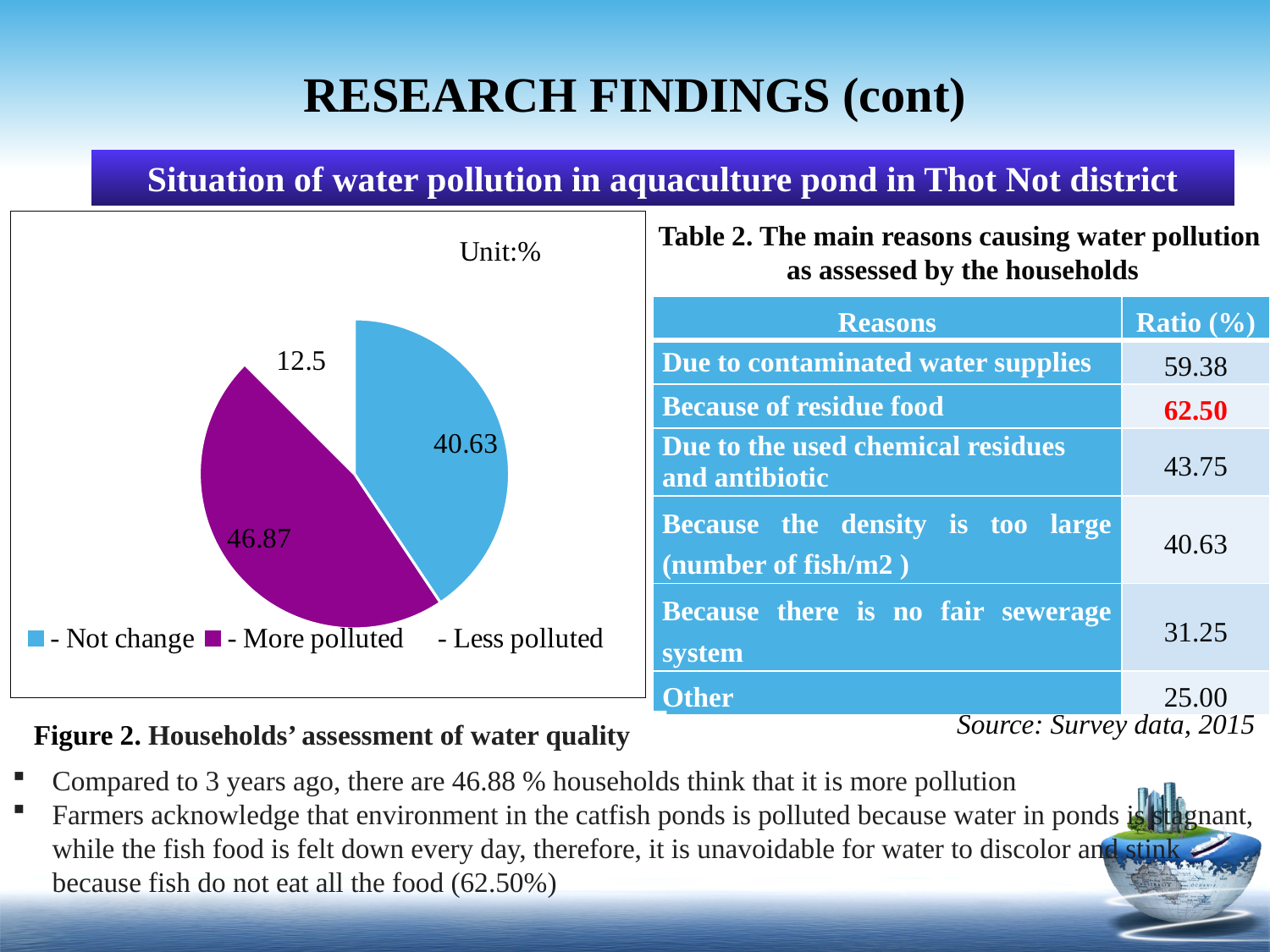
In the pie chart, what is the value for 'More polluted'? 46.87 In the pie chart, what is the value for 'Not change'? 40.63 In the pie chart, what is the difference between the 'More polluted' and 'Not change' values? 6.24 In the pie chart, what is the value for 'Less polluted'? 12.5 What colour is the 'More polluted' slice in the pie chart? Purple Which category has the smallest slice in the pie chart? Less polluted In the pie chart, which is larger: 'Not change' or 'Less polluted'? Not change In the pie chart, what is the difference between the 'Not change' and 'Less polluted' values? 28.13 Which category has the largest slice in the pie chart? More polluted What unit is indicated for the values in the pie chart? % How many categories does the pie chart show? 3 What kind of chart is shown in Figure 2 on the slide? Pie chart